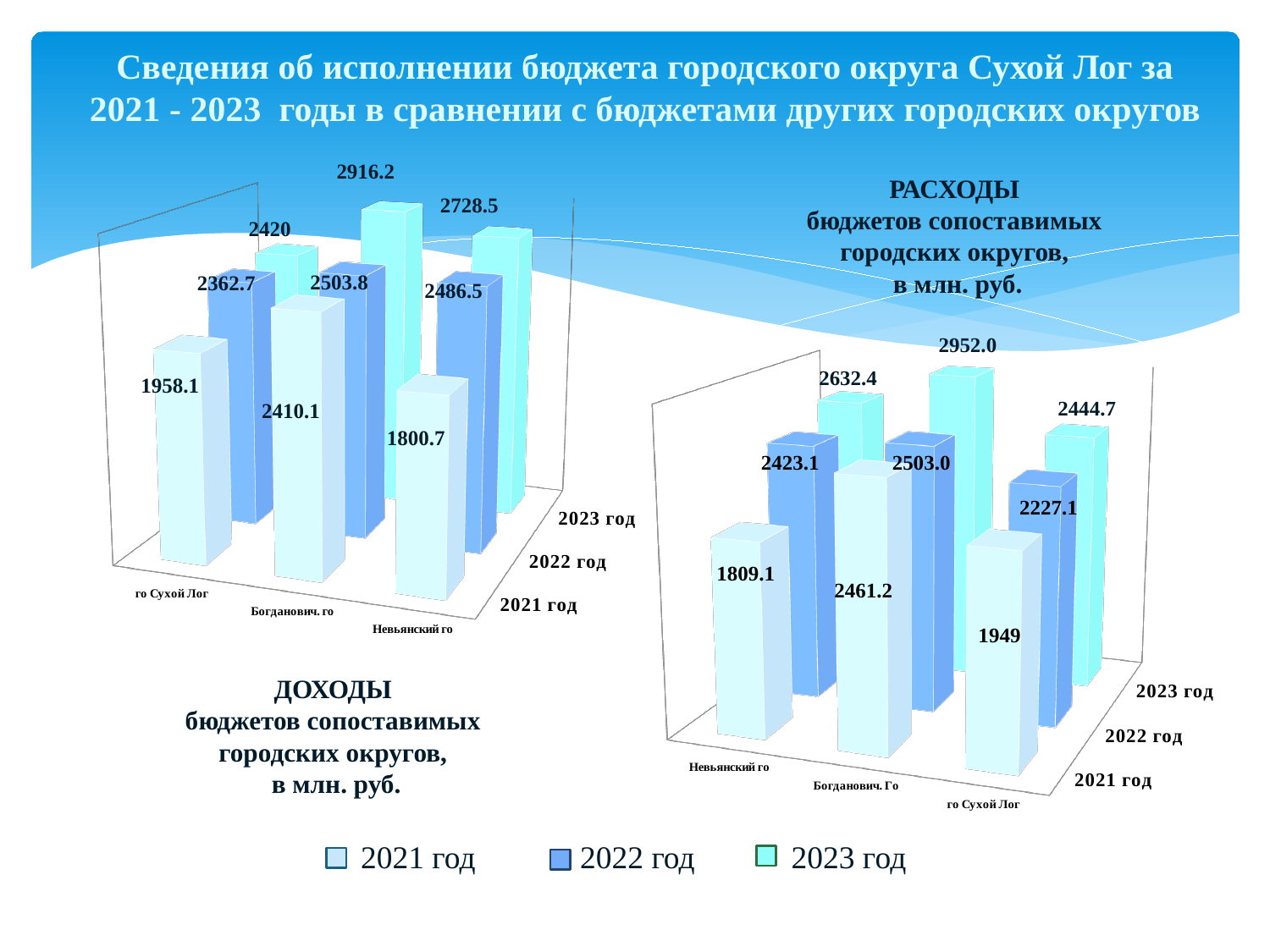
In the ДОХОДЫ chart (left), do the values for Невьянский го rise or fall from 2021 год to 2023 год? rise In the РАСХОДЫ chart (right), which is larger: the 2022 год value for Невьянский го or the 2022 год value for го Сухой Лог? Невьянский го In the ДОХОДЫ chart (left), what is the value for го Сухой Лог in 2021 год? 1958.1 In the ДОХОДЫ chart (left), what is the value for Богданович. го in 2023 год? 2916.2 What kind of chart is the РАСХОДЫ chart (right)? bar chart In the РАСХОДЫ chart (right), what is the value for го Сухой Лог in 2021 год? 1949 How many series does the legend list? 3 In the ДОХОДЫ chart (left), what is the difference between the 2023 год and 2021 год values for го Сухой Лог? 461.9 In the РАСХОДЫ chart (right), which category has the highest value in 2023 год? Богданович. Го In the ДОХОДЫ chart (left), what is the value for Невьянский го in 2022 год? 2486.5 In the ДОХОДЫ chart (left), which category has the lowest value in 2021 год? Невьянский го In the РАСХОДЫ chart (right), what is the value for Богданович. Го in 2023 год? 2952.0